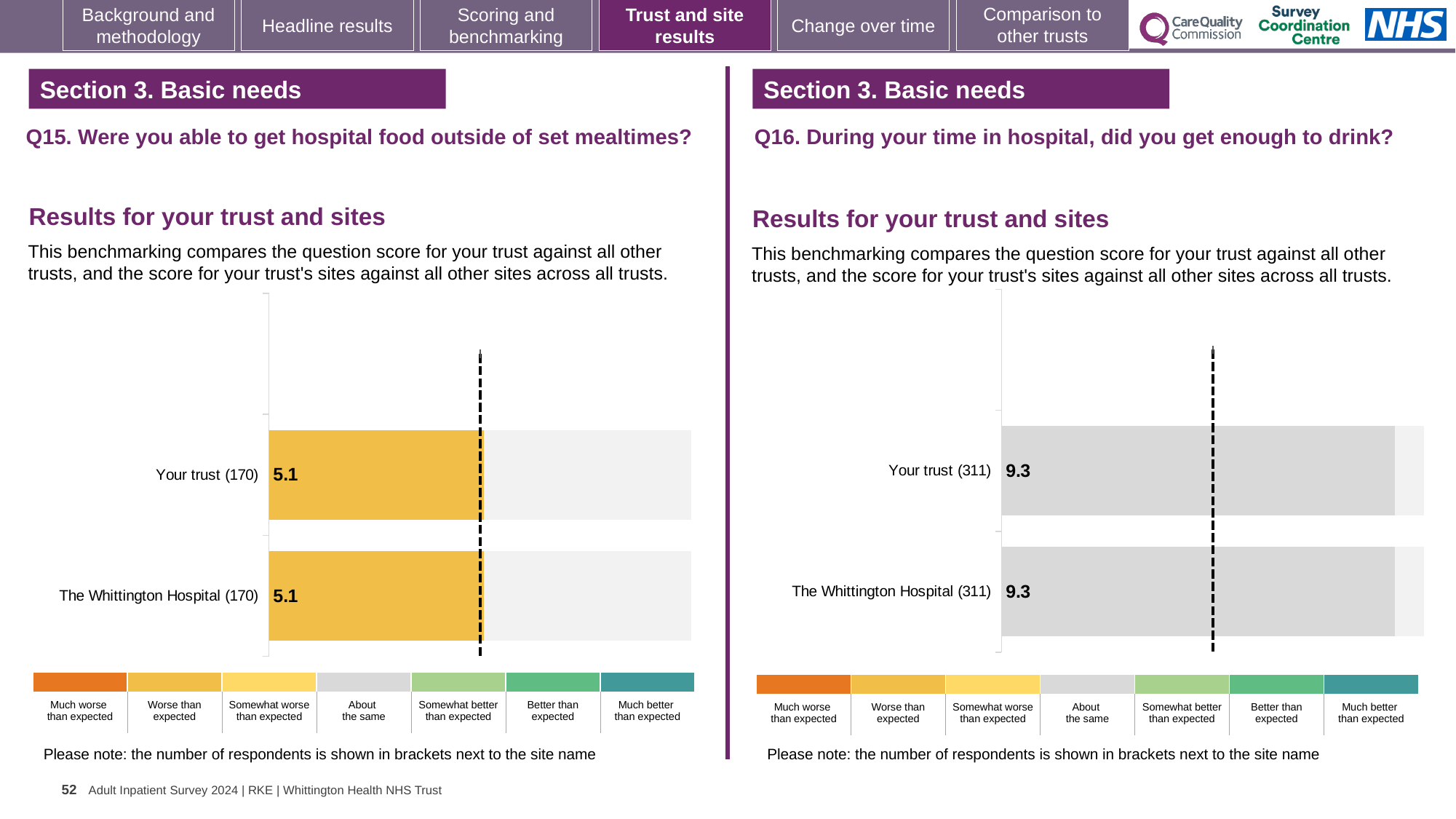
How many bars are plotted in the Q16 chart (right)? 2 In the Q16 chart (right), what is the score for The Whittington Hospital? 9.3 In the Q15 chart (left), what is the score for Your trust? 5.1 What type of chart is used for the Q15 results (left)? Bar chart In the Q15 chart (left), what is the difference between the score for Your trust and the score for The Whittington Hospital? 0 How many bars are plotted in the Q15 chart (left)? 2 In the Q16 chart (right), how many respondents are shown in brackets for The Whittington Hospital? 311 In the Q15 chart (left), what is the score for The Whittington Hospital? 5.1 In the Q15 chart (left), how many respondents are shown in brackets for Your trust? 170 In the Q16 chart (right), what is the difference between the score for Your trust and the score for The Whittington Hospital? 0 In the Q16 chart (right), what is the score for Your trust? 9.3 Is the score for Your trust in the Q16 chart (right) larger or smaller than the score for Your trust in the Q15 chart (left)? Larger